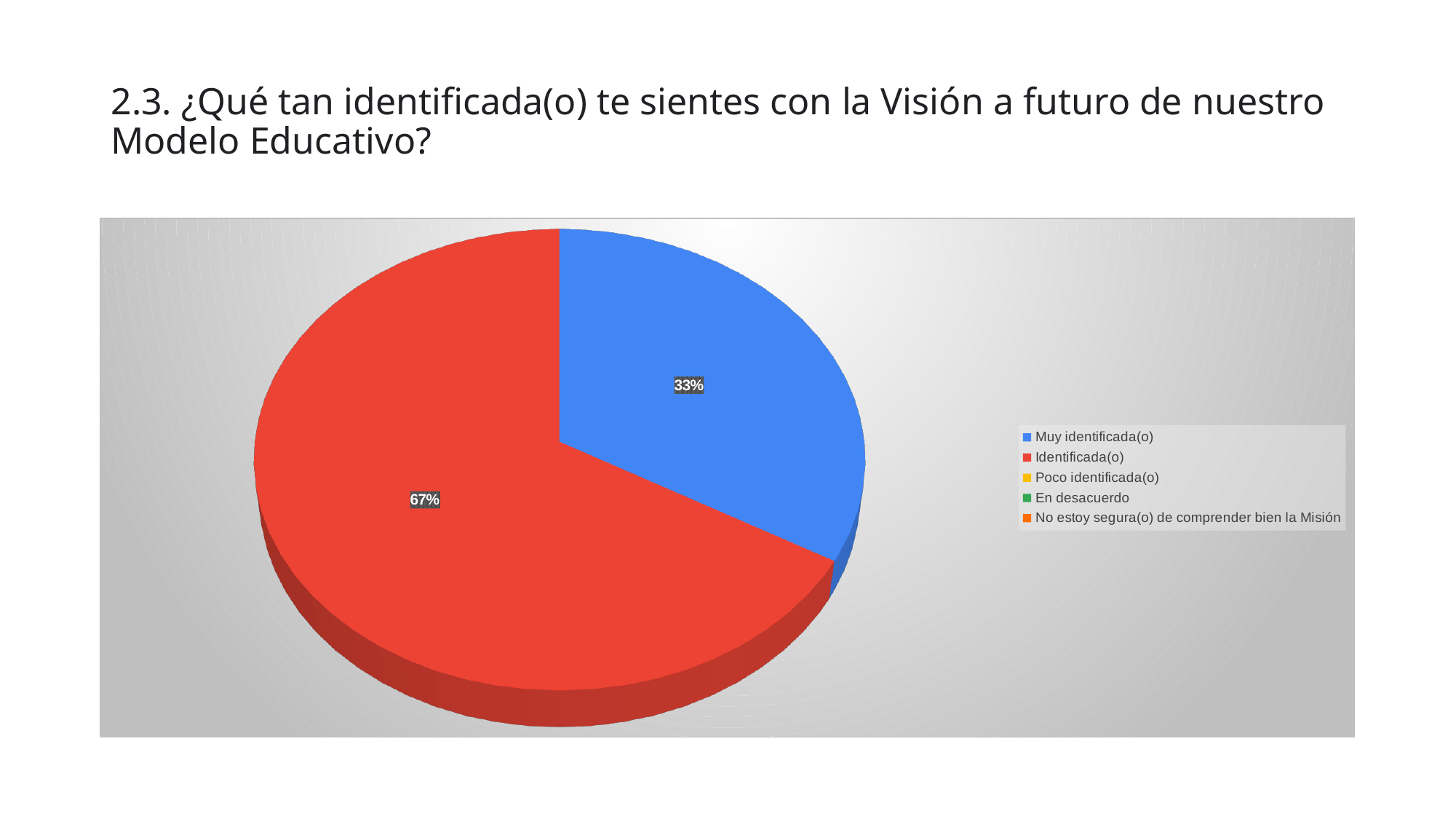
What is the difference in percentage points between the "Identificada(o)" slice and the "Muy identificada(o)" slice? 34% What kind of chart is shown on the slide? Pie chart Which legend entry is shown in red? Identificada(o) Which category has the largest slice of the pie? Identificada(o) What colour is the "Muy identificada(o)" slice? Blue How many entries does the legend list? 5 How many slices are visible in the pie? 2 Which of the two visible slices is larger, "Muy identificada(o)" or "Identificada(o)"? Identificada(o) Is the share for "Identificada(o)" greater or less than 50%? greater What share of the pie does "Muy identificada(o)" represent? 33% What share of the pie does "Identificada(o)" represent? 67%